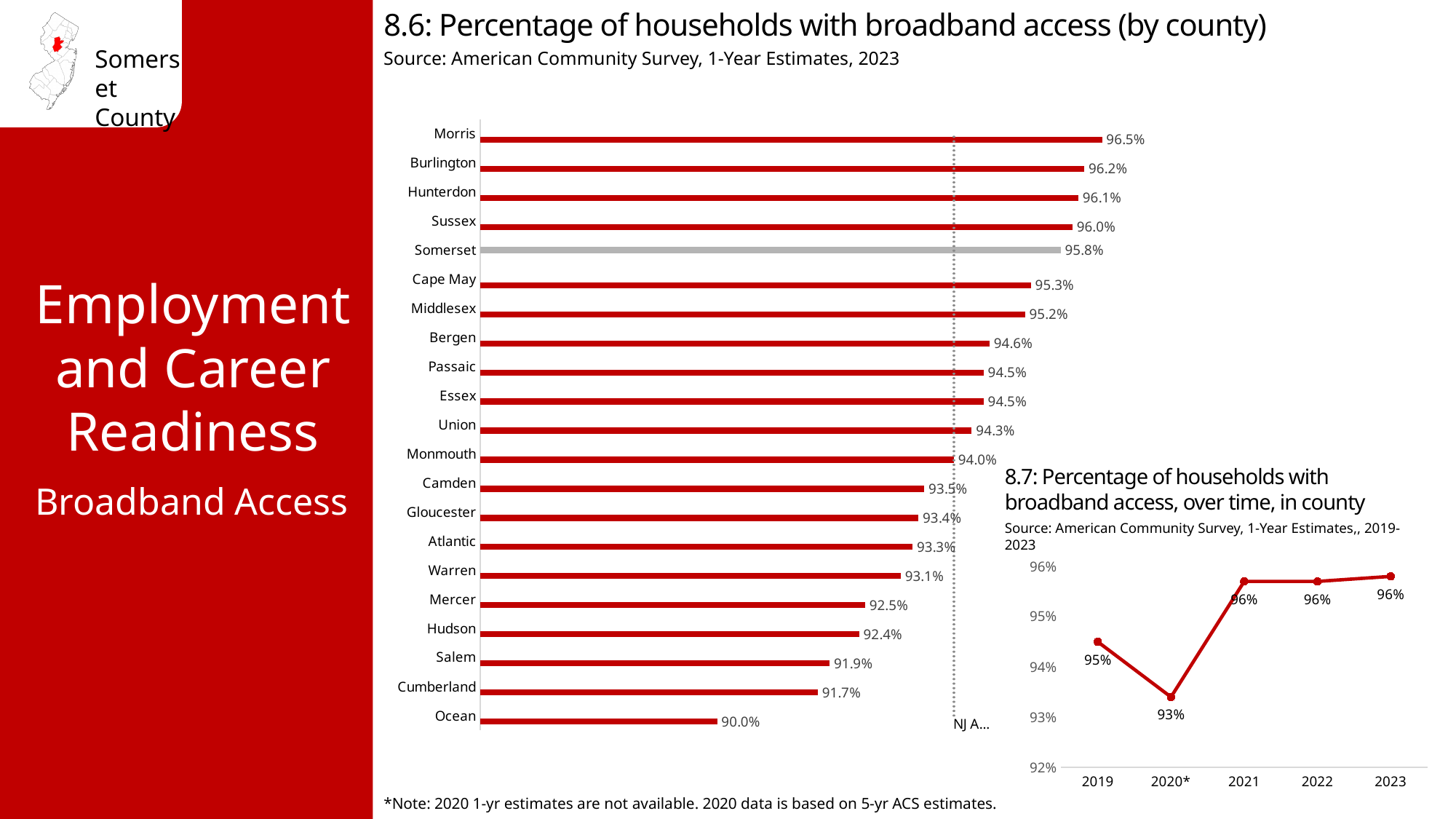
In chart 8.6, which county has the lowest percentage of households with broadband access? Ocean In chart 8.6, which county has the highest percentage of households with broadband access? Morris In chart 8.6, which county has a higher value, Bergen or Mercer? Bergen In chart 8.6, which county's bar is shown in grey instead of red? Somerset In chart 8.7, which year has the lowest percentage of households with broadband access? 2020* In chart 8.6, what is the percentage of households with broadband access in Somerset County? 95.8% In chart 8.7, what is the value for 2020*? 93% How many counties are shown in chart 8.6? 21 What kind of chart is chart 8.6? Bar chart How many data points are plotted in chart 8.7? 5 In chart 8.6, what is the value for Cumberland County? 91.7% In chart 8.6, what is the difference between Morris County's value and Ocean County's value? 6.5 percentage points